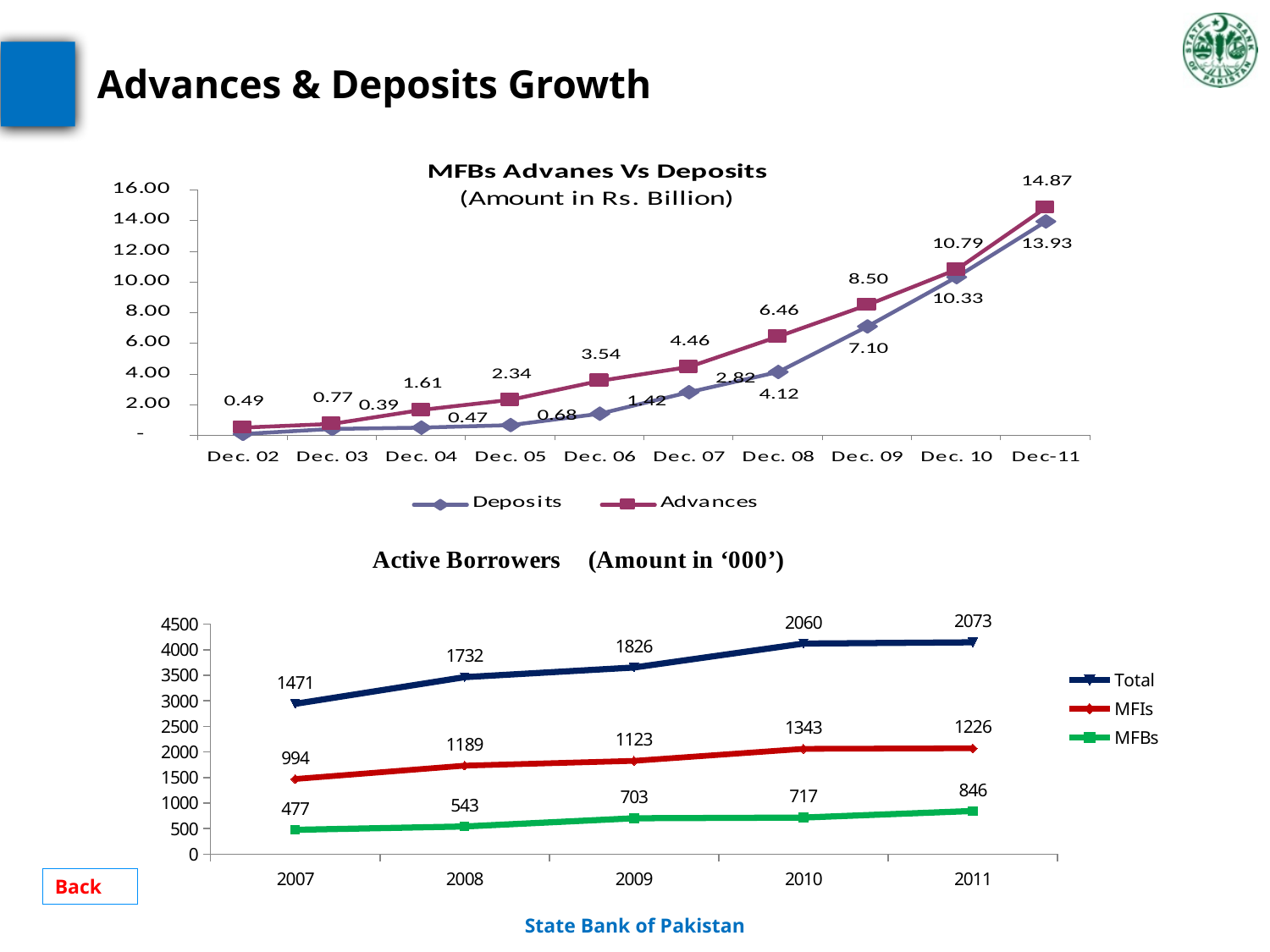
In the top chart (MFBs Advanes Vs Deposits), what is the Deposits value for Dec-11? 13.93 In the bottom chart (Active Borrowers), how many series does the legend list? 3 In the bottom chart (Active Borrowers), in which year is the Total value highest? 2011 In the top chart (MFBs Advanes Vs Deposits), how many series does the legend list? 2 In the bottom chart (Active Borrowers), what is the MFIs value for 2010? 1343 In the top chart (MFBs Advanes Vs Deposits), do the Advances values rise or fall from Dec. 02 to Dec-11? Rise In the top chart (MFBs Advanes Vs Deposits), how many time points are shown on the x axis? 10 What kind of chart is the top chart (MFBs Advanes Vs Deposits)? Line chart In the bottom chart (Active Borrowers), what is the MFBs value for 2011? 846 In the top chart (MFBs Advanes Vs Deposits), what is the Advances value for Dec-11? 14.87 In the top chart (MFBs Advanes Vs Deposits), what is the difference between Advances and Deposits in Dec-11? 0.94 In the top chart (MFBs Advanes Vs Deposits), what is the Advances value for Dec. 09? 8.50